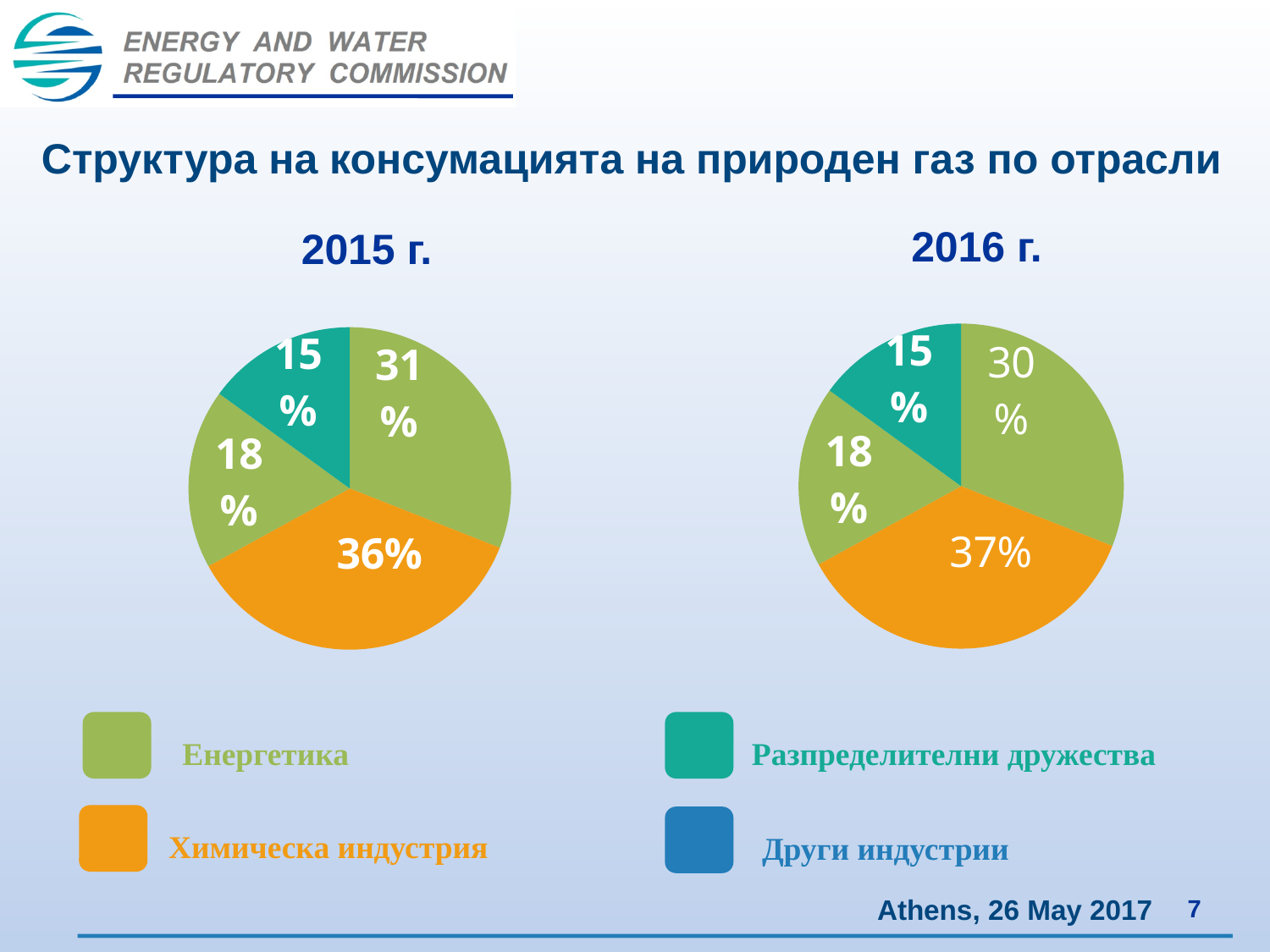
How many slices does each pie chart have? 4 In the 2015 pie chart, what share does the orange slice (Химическа индустрия) have? 36% In the 2015 pie chart, which is larger: the 31% slice or the 18% slice? The 31% slice In the 2015 pie chart, what share does the teal slice (Разпределителни дружества) have? 15% What kind of charts are shown on the slide? Pie charts In the 2015 pie chart, which category has the largest slice? Химическа индустрия In the 2016 pie chart, what share does the orange slice (Химическа индустрия) have? 37% How many entries does the legend list? 4 In the 2016 pie chart, what share does the teal slice (Разпределителни дружества) have? 15% In the 2016 pie chart, which category has the largest slice? Химическа индустрия By how many percentage points did the Химическа индустрия share change from the 2015 pie chart to the 2016 pie chart? 1 percentage point In the 2015 pie chart, which category has the smallest slice? Разпределителни дружества